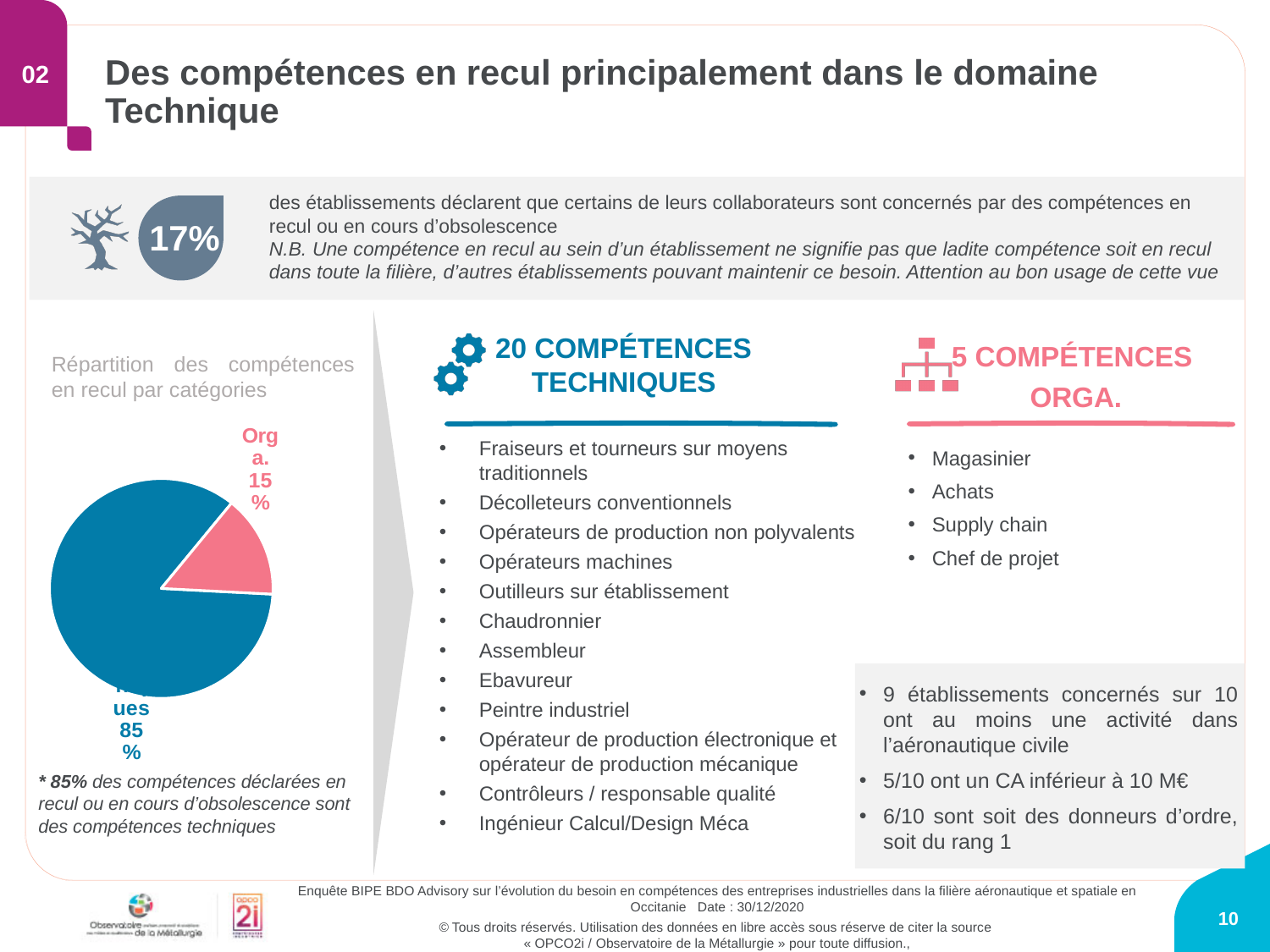
How many slices does the pie chart have? 2 In the pie chart, what share is labelled for "Orga."? 15% Which slice of the pie chart is the largest? Techniques Is the share of the Orga. slice in the pie chart greater or less than 50%? less What is the title of the pie chart? Répartition des compétences en recul par catégories In the pie chart, which is larger: the Orga. slice or the Techniques slice? Techniques In the pie chart, what share is labelled for the "Techniques" slice? 85% What is the difference in percentage points between the Techniques slice and the Orga. slice in the pie chart? 70 What colour is the Orga. slice in the pie chart? pink Which slice of the pie chart is the smallest? Orga. What kind of chart is shown under "Répartition des compétences en recul par catégories"? pie chart